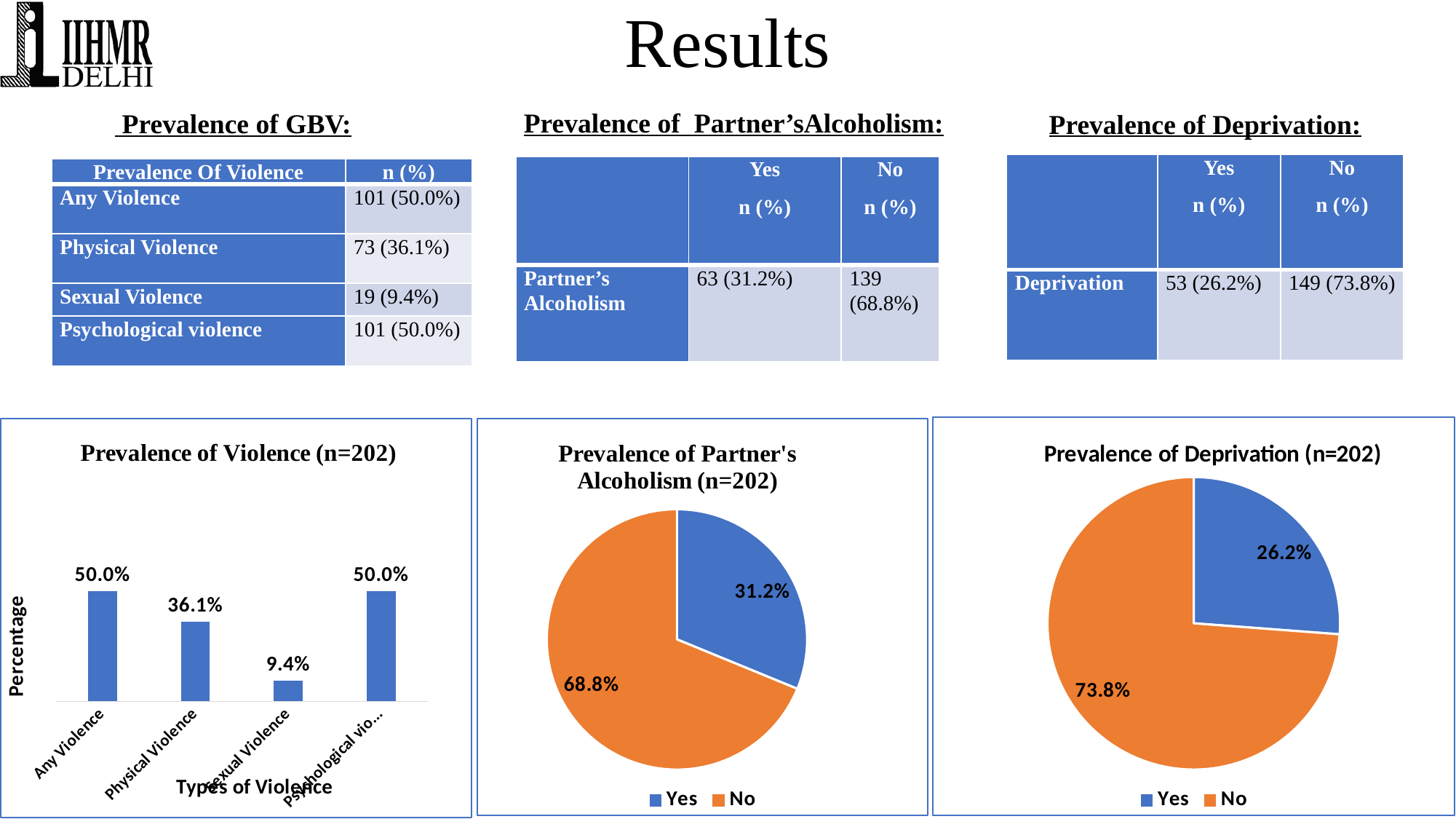
What kind of chart is 'Prevalence of Violence (n=202)'? Bar chart In the 'Prevalence of Partner's Alcoholism (n=202)' pie chart, which slice is larger, Yes or No? No In the 'Prevalence of Violence (n=202)' chart, which is larger, the value for Physical Violence or the value for Sexual Violence? Physical Violence In the 'Prevalence of Partner's Alcoholism (n=202)' pie chart, what share does the 'Yes' slice have? 31.2% In the 'Prevalence of Violence (n=202)' chart, what is the value for Sexual Violence? 9.4% How many entries does the legend of the 'Prevalence of Deprivation (n=202)' chart list? 2 In the 'Prevalence of Violence (n=202)' chart, what is the difference between the values for Physical Violence and Sexual Violence? 26.7% In the 'Prevalence of Deprivation (n=202)' pie chart, what share does the 'No' slice have? 73.8% In the 'Prevalence of Violence (n=202)' chart, which type of violence has the lowest percentage? Sexual Violence How many bars are plotted in the 'Prevalence of Violence (n=202)' chart? 4 In the 'Prevalence of Violence (n=202)' chart, what is the value for Physical Violence? 36.1% What is the x-axis title of the 'Prevalence of Violence (n=202)' chart? Types of Violence